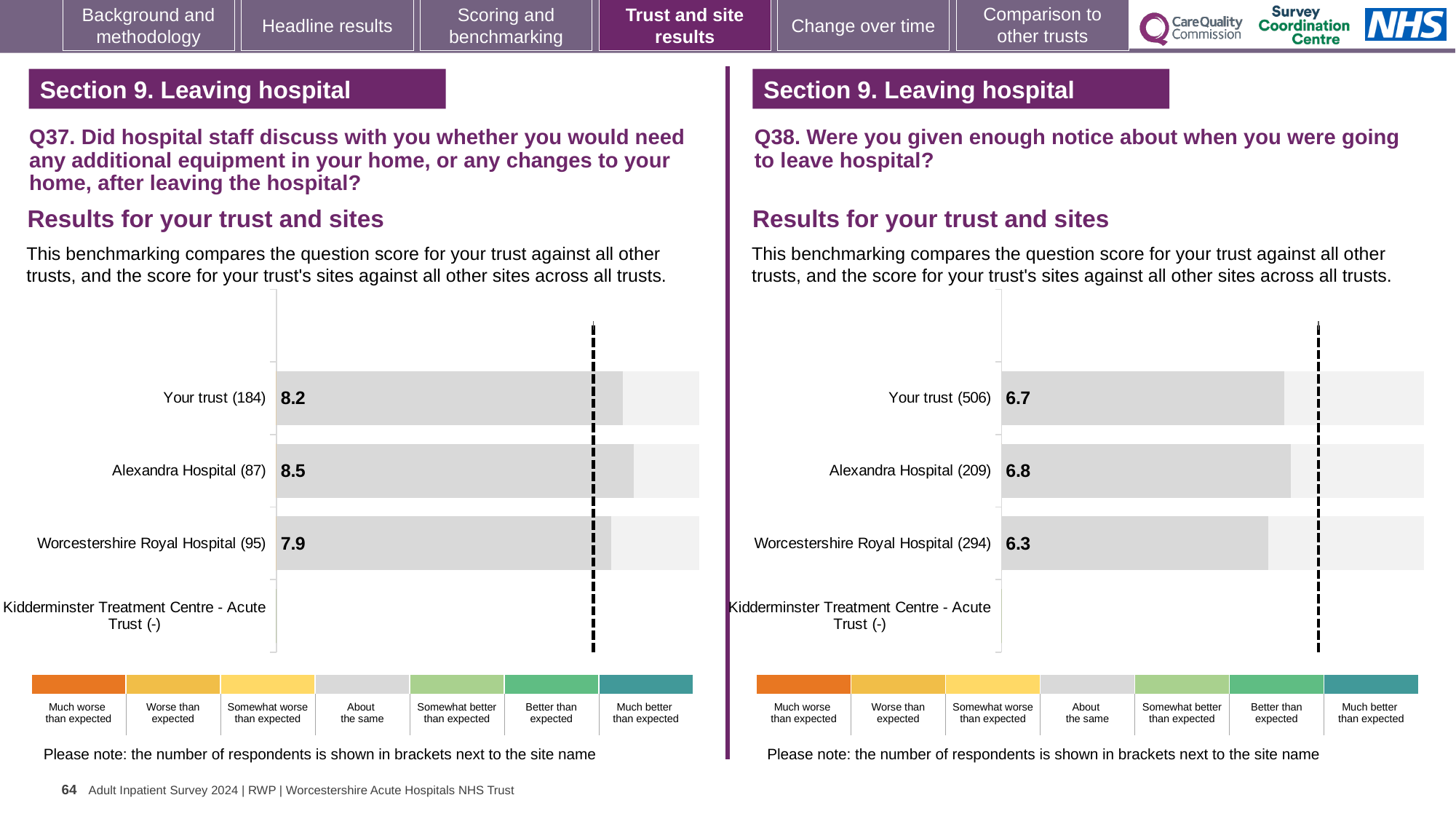
In the Q38 chart on the right, what is the score for Worcestershire Royal Hospital? 6.3 In the Q37 chart on the left, what is the difference between the scores for Alexandra Hospital and Worcestershire Royal Hospital? 0.6 In the Q37 chart on the left, which site has the highest score? Alexandra Hospital In the Q38 chart on the right, which has the larger score, Alexandra Hospital or Worcestershire Royal Hospital? Alexandra Hospital In the Q37 chart on the left, what is the score for Worcestershire Royal Hospital? 7.9 In the Q38 chart on the right, which site has the lowest score? Worcestershire Royal Hospital In the Q38 chart on the right, what is the difference between the scores for Alexandra Hospital and Your trust? 0.1 What type of chart is used on the left for Q37? Bar chart In the Q37 chart on the left, what is the score for Alexandra Hospital? 8.5 In the Q38 chart on the right, what is the score for Your trust? 6.7 In the Q37 chart on the left, what is the score for Your trust? 8.2 In the Q37 chart on the left, how many respondents are shown in brackets for Your trust? 184